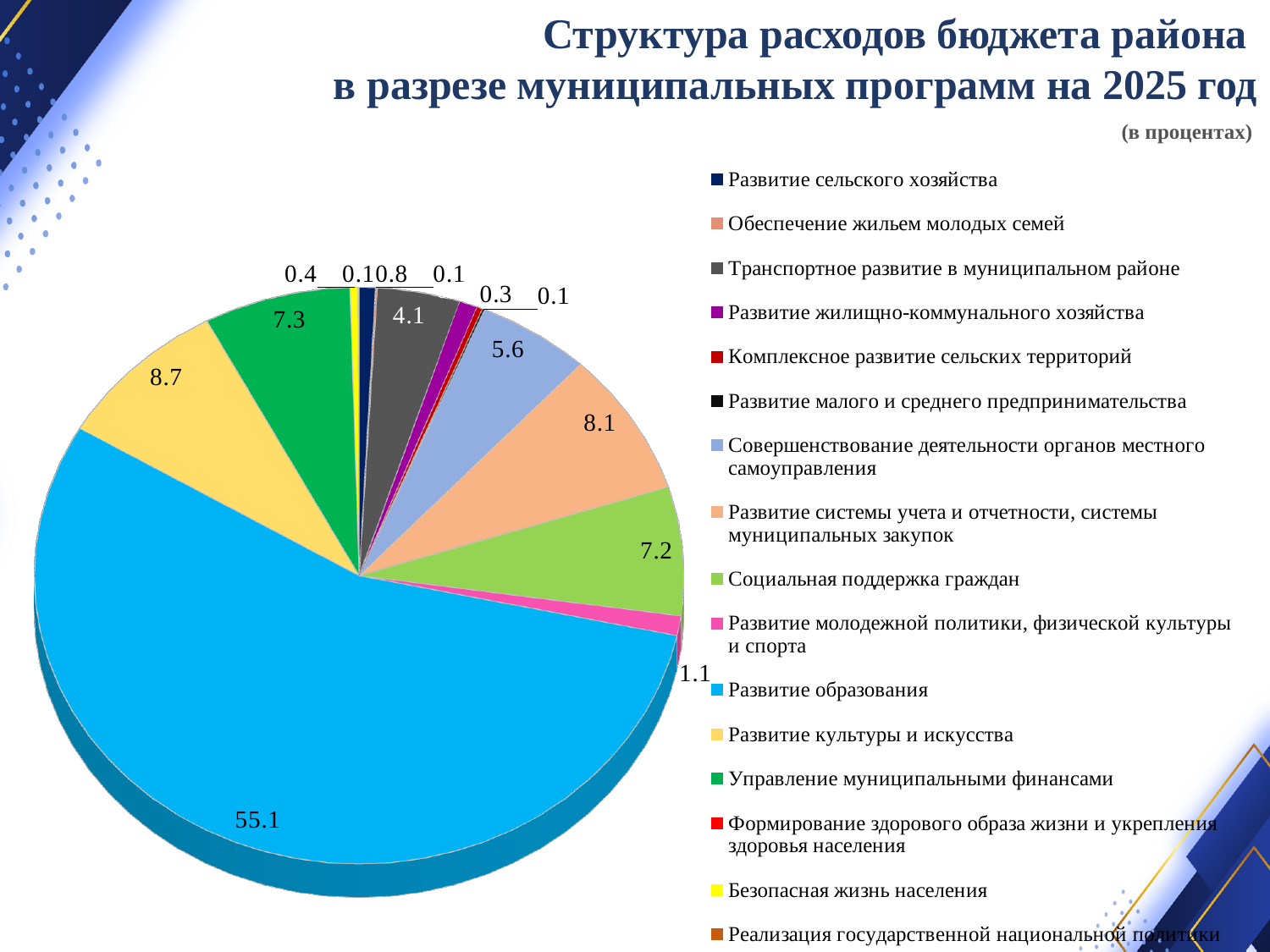
What is the value for Развитие образования? 55.1 How many categories does the legend list? 16 Which is larger, Развитие системы учета и отчетности, системы муниципальных закупок or Социальная поддержка граждан? Развитие системы учета и отчетности, системы муниципальных закупок What is the difference between the values for Развитие культуры и искусства and Управление муниципальными финансами? 1.4 What is the value for Совершенствование деятельности органов местного самоуправления? 5.6 What is the value for Социальная поддержка граждан? 7.2 What is the value for Развитие культуры и искусства? 8.7 What is the value for Транспортное развитие в муниципальном районе? 4.1 Which category has the largest share of the pie? Развитие образования What is the value for Управление муниципальными финансами? 7.3 In what units are the values shown, according to the note under the title? в процентах What kind of chart is shown on the slide? pie chart